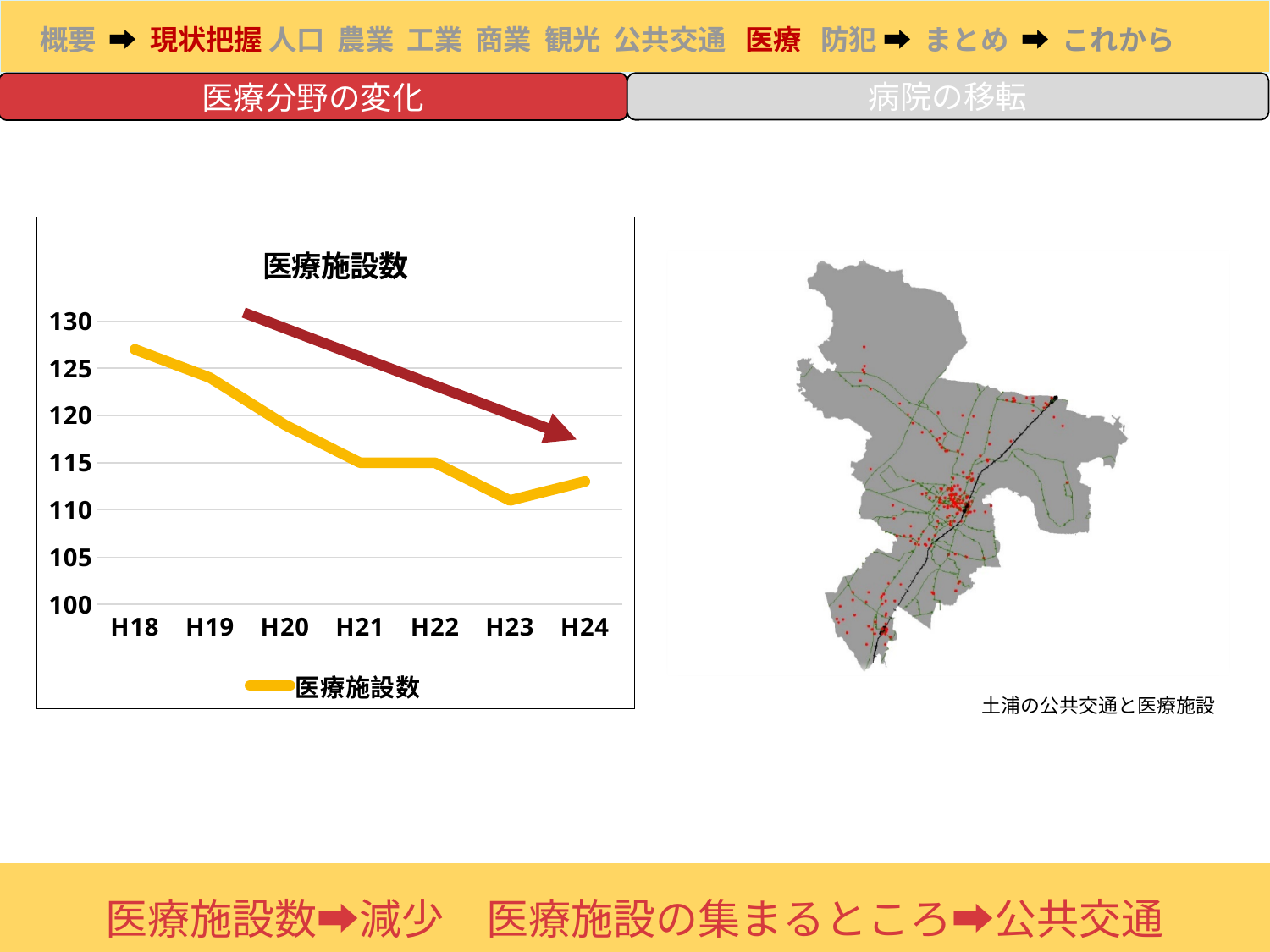
How many years (data points) are plotted on the x axis of the chart? 7 What kind of chart is shown on the slide? line chart Is the value for H18 greater or less than 125? greater Is the value for H23 greater or less than 115? less What is the title of the chart? 医療施設数 Is the value for H24 greater or less than 110? greater Do the values for 医療施設数 generally rise or fall from H18 to H24? fall Which year has the highest value for 医療施設数? H18 Which is larger, the value for H19 or the value for H22? H19 How many series does the chart legend list? 1 What is the label of the series shown in the chart legend? 医療施設数 Which year has the lowest value for 医療施設数? H23